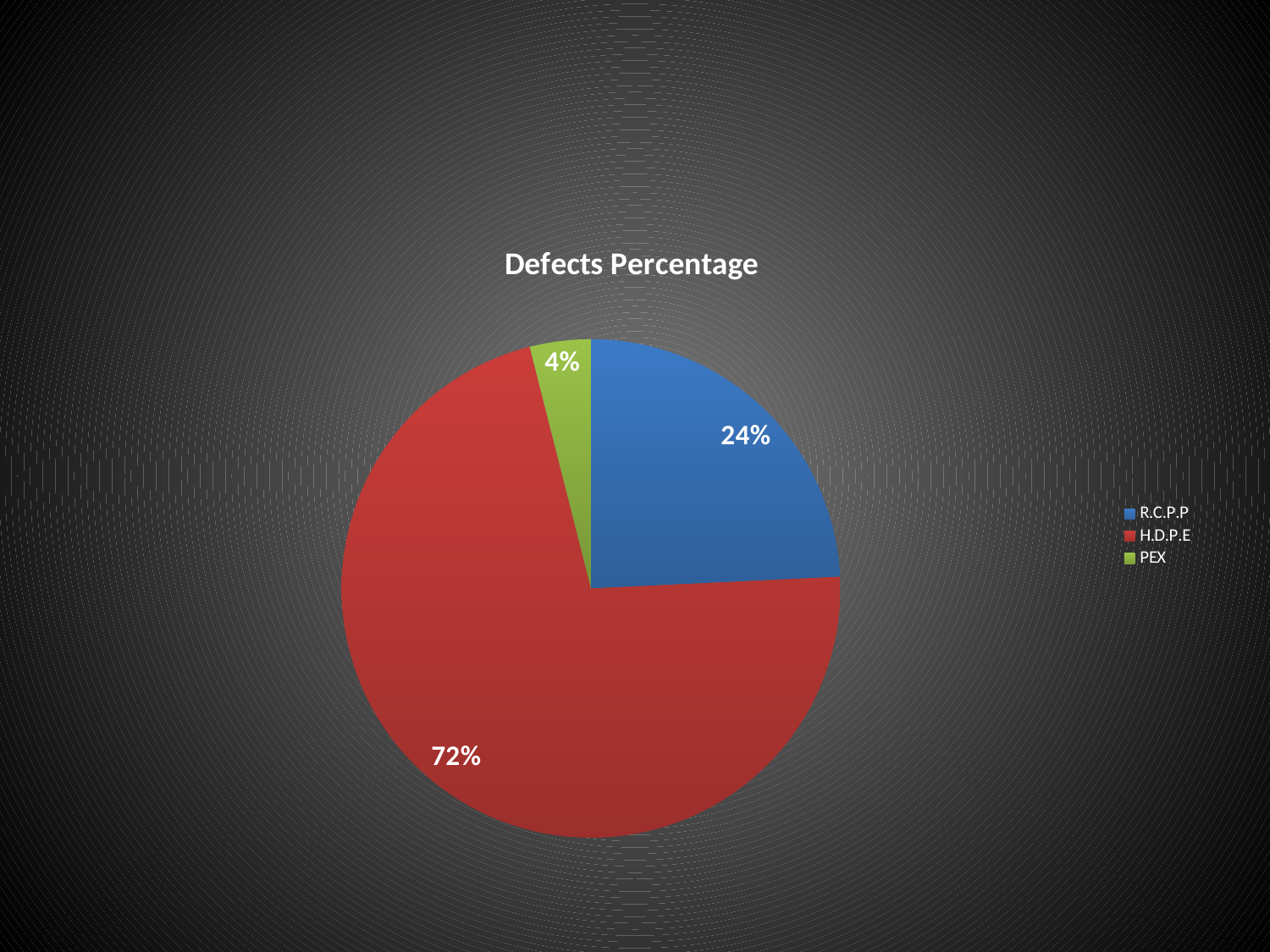
What colour represents H.D.P.E in the chart? red What percentage of defects is attributed to R.C.P.P? 24% Which category has the largest share of defects? H.D.P.E What percentage of defects is attributed to H.D.P.E? 72% What is the title of the chart? Defects Percentage What type of chart is shown on the slide? pie chart What is the difference in percentage points between H.D.P.E and R.C.P.P? 48 How many categories does the pie chart show? 3 What percentage of defects is attributed to PEX? 4% What is the difference in percentage points between R.C.P.P and PEX? 20 Which category has the smallest share of defects? PEX Which has a larger share of defects, R.C.P.P or PEX? R.C.P.P